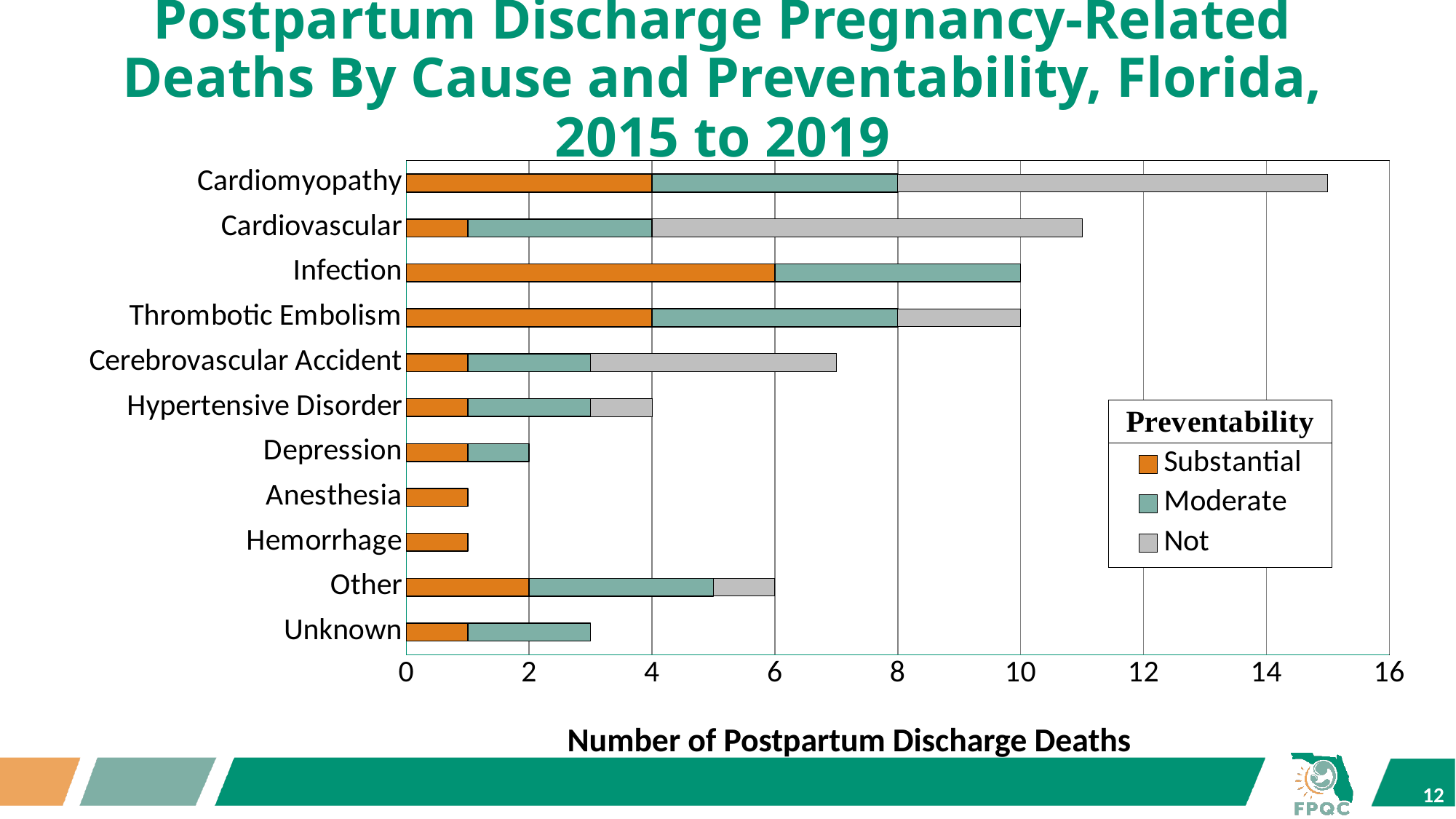
Is the total number of deaths for Cerebrovascular Accident greater or less than 8? less How many preventability categories does the legend list? 3 What is the total number of postpartum discharge deaths for Other? 6 What is the total number of postpartum discharge deaths for Infection? 10 What kind of chart is shown on the slide? Stacked bar chart Which has more total deaths, Cardiomyopathy or Cardiovascular? Cardiomyopathy Which cause has the highest total number of postpartum discharge deaths? Cardiomyopathy What is the difference between the total deaths for Infection and the total deaths for Other? 4 What is the title of the legend? Preventability How many Infection deaths were rated Substantial preventability? 6 How many causes of death are listed on the vertical axis? 11 Is the total number of deaths for Cardiomyopathy greater or less than 14? greater